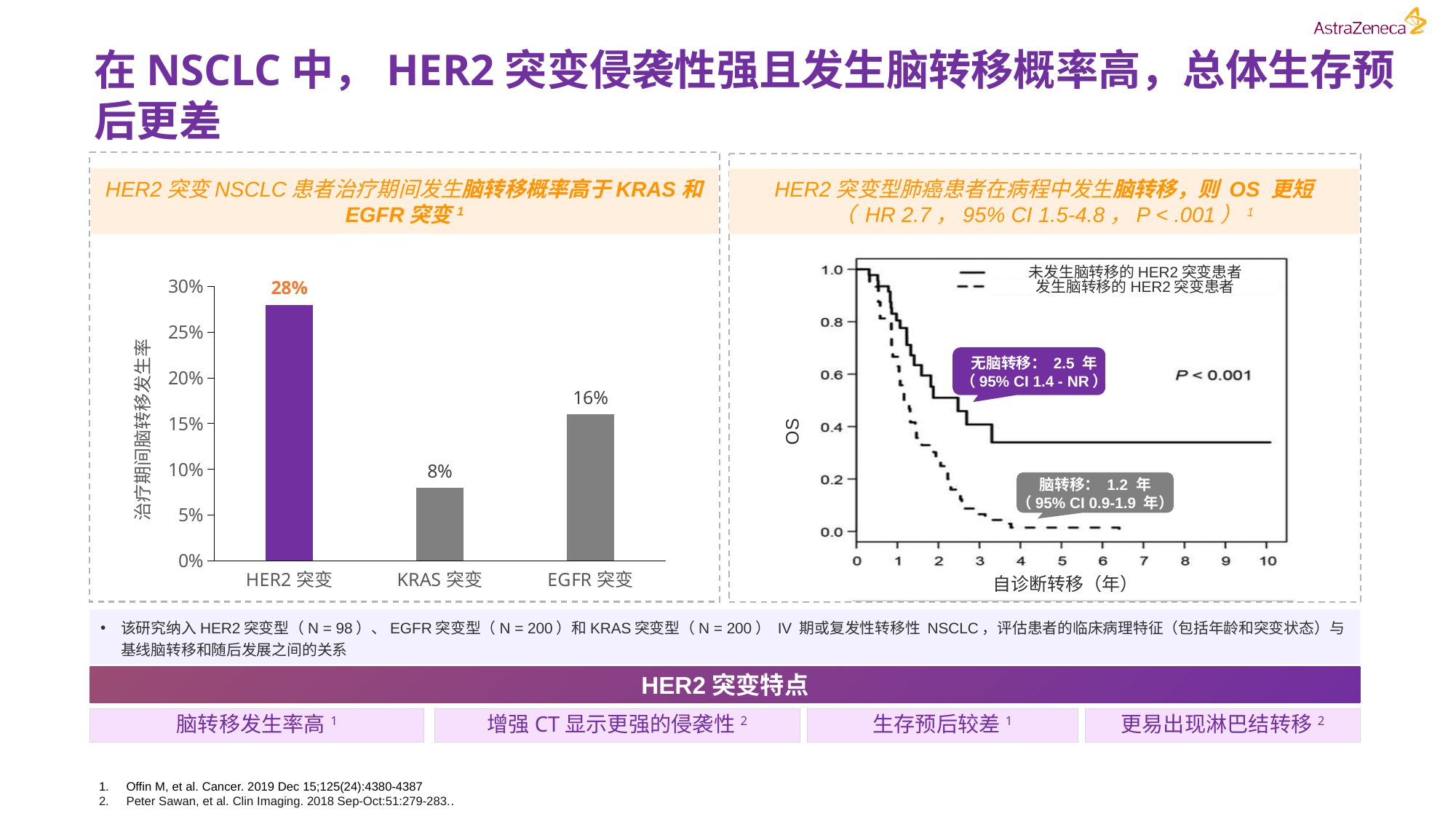
In the left bar chart, what is the value for KRAS 突变? 8% In the right survival chart, what is the median OS for HER2-mutant patients with brain metastasis (脑转移)? 1.2 年 In the left bar chart, which is larger, the value for EGFR 突变 or the value for KRAS 突变? EGFR 突变 In the left bar chart, what is the difference between the EGFR 突变 and KRAS 突变 values? 8% In the left bar chart, what is the difference between the HER2 突变 and EGFR 突变 values? 12% In the left bar chart, which mutation category has the highest brain metastasis rate? HER2 突变 What kind of chart is shown on the left side of the slide? Bar chart In the left bar chart, what is the brain metastasis rate during treatment for HER2 突变? 28% In the left bar chart, what is the value for EGFR 突变? 16% How many categories are shown in the left bar chart? 3 In the right survival chart, what is the median OS for HER2-mutant patients without brain metastasis (无脑转移)? 2.5 年 In the left bar chart, which mutation category has the lowest brain metastasis rate? KRAS 突变